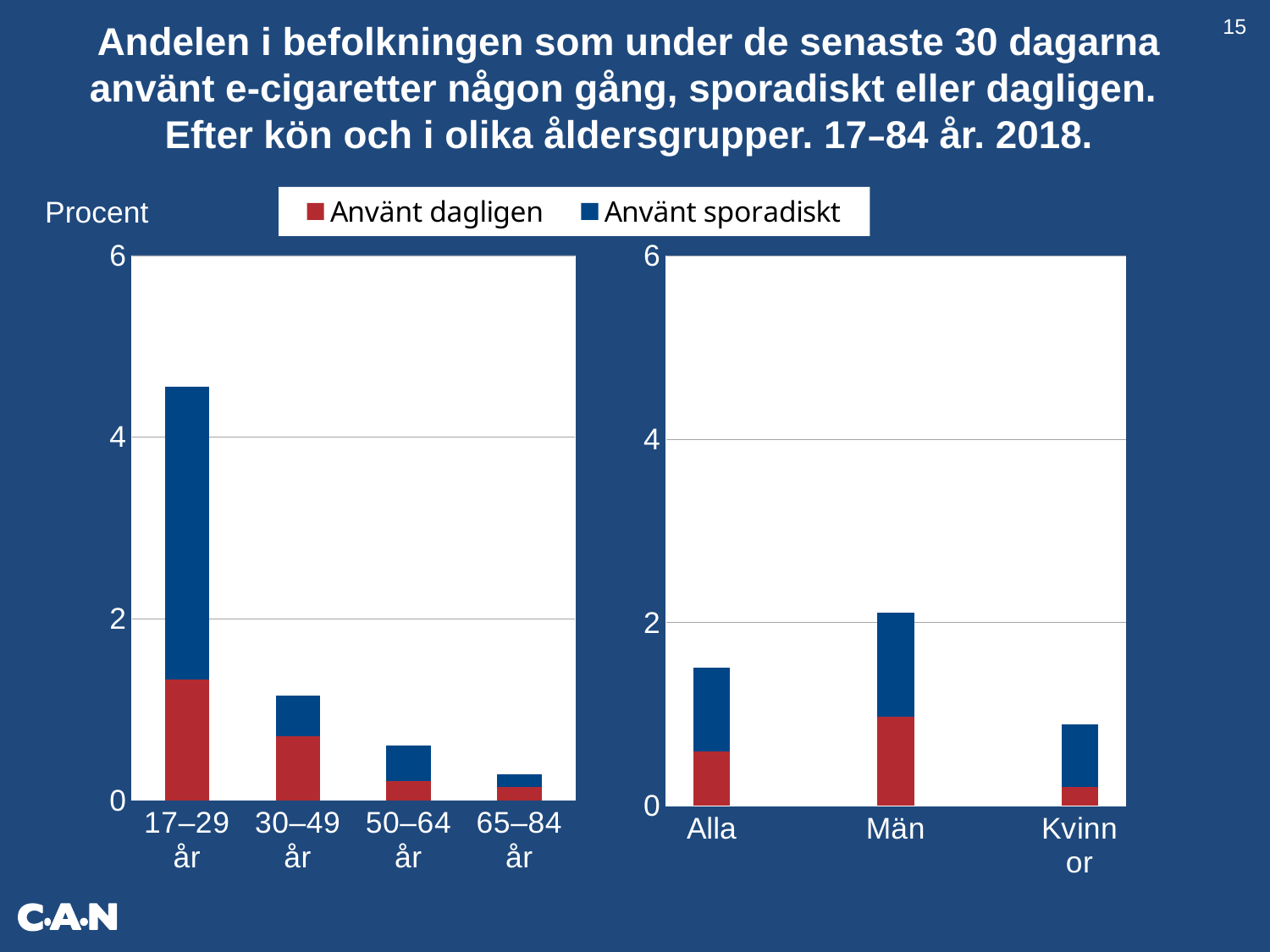
On the right chart, which category has the lowest total bar? Kvinnor On the left chart, which age group has the highest total bar? 17–29 år On the right chart, which category has the highest total bar? Män How many categories are shown on the right chart (Alla, Män, Kvinnor)? 3 On the left chart, is the total value for 17–29 år greater or less than 4? greater What kind of chart is the left chart showing age groups? stacked bar chart On the left chart, do the total bar heights rise or fall as age increases along the x axis? fall On the left chart, which age group has the lowest total bar? 65–84 år On the right chart, is the total value for Alla greater or less than 2? less Which colour represents 'Använt dagligen' in the legend? red How many age groups are shown on the left chart? 4 How many series does the legend list? 2